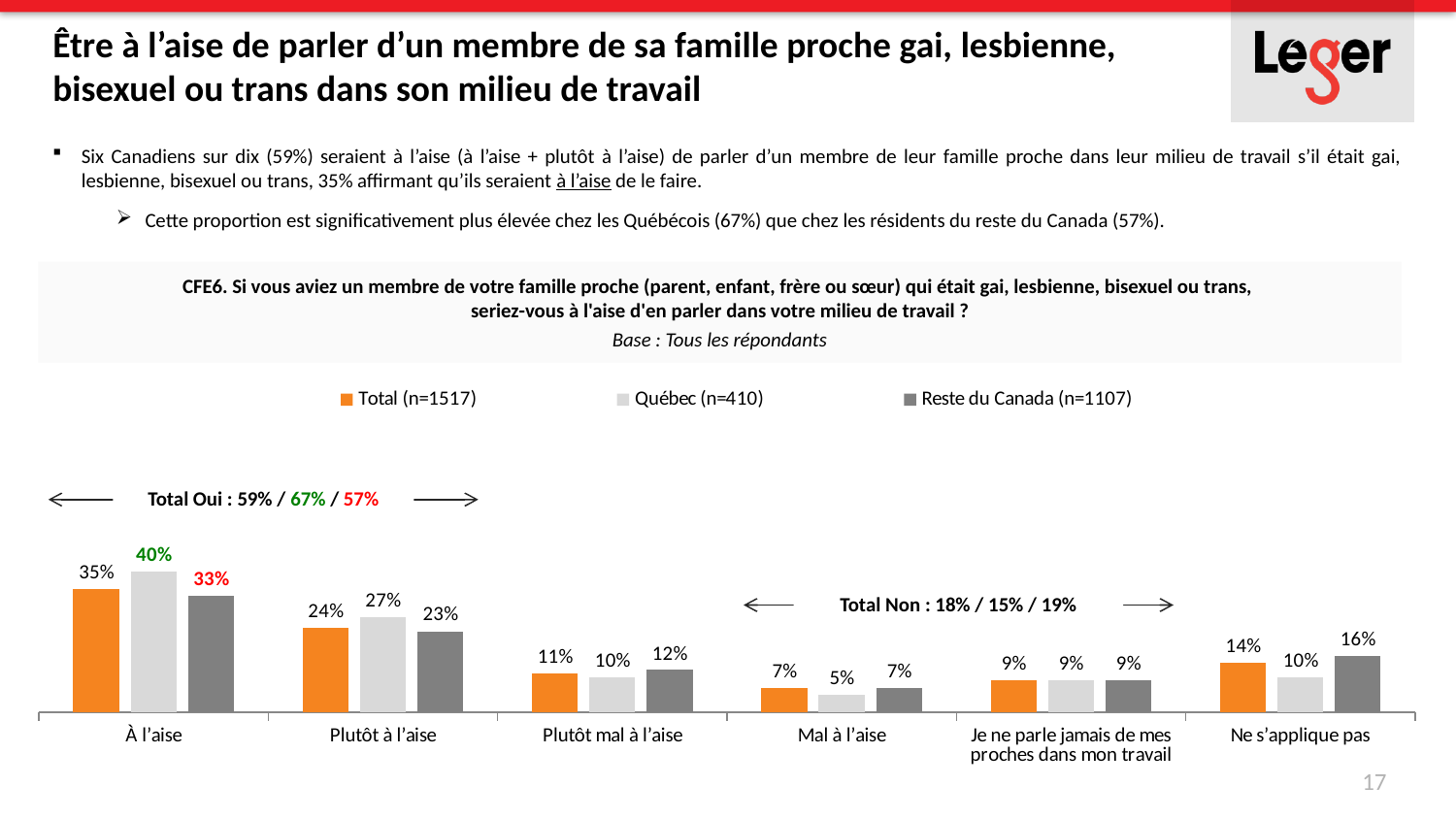
What is the value for Québec (n=410) in the "À l'aise" category? 40% In the "Ne s'applique pas" category, which is larger: the Québec (n=410) value or the Reste du Canada (n=1107) value? Reste du Canada (n=1107) How many series does the chart legend list? 3 What is the value for Reste du Canada (n=1107) in the "Ne s'applique pas" category? 16% What is the "Total Oui" value shown for Québec on the chart? 67% Which category has the lowest value for the Québec (n=410) series? Mal à l'aise What is the value for Québec (n=410) in the "Mal à l'aise" category? 5% What is the value for Total (n=1517) in the "Plutôt à l'aise" category? 24% Which category has the highest value for the Total (n=1517) series? À l'aise What kind of chart is shown on the slide? Bar chart How many categories are shown on the x axis of the chart? 6 What is the difference between the Québec (n=410) and Reste du Canada (n=1107) values in the "À l'aise" category? 7%